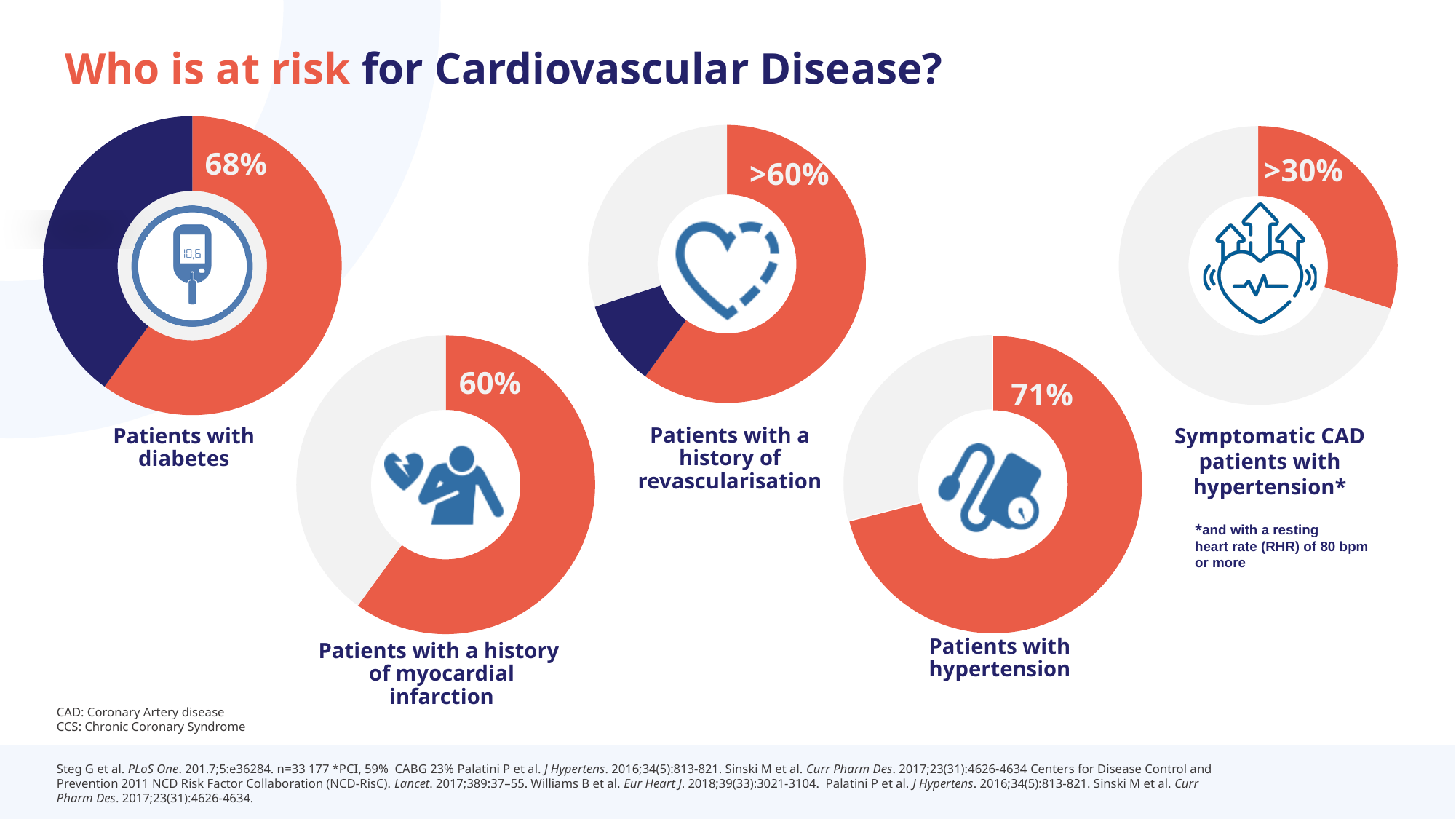
In the chart labelled 'Patients with a history of revascularisation', what value is printed? >60% Comparing the 'Patients with diabetes' chart and the 'Patients with hypertension' chart, which shows the larger percentage? Patients with hypertension In the chart labelled 'Patients with diabetes', what percentage is shown? 68% Across all the charts on the slide, which patient group has the highest printed percentage? Patients with hypertension What is the difference between the percentage in the 'Patients with hypertension' chart and the percentage in the 'Patients with diabetes' chart? 3 percentage points In the chart labelled 'Patients with hypertension', what percentage is shown? 71% In the chart labelled 'Symptomatic CAD patients with hypertension*', what value is printed? >30% Across all the charts on the slide, which patient group has the lowest printed value? Symptomatic CAD patients with hypertension* How many donut charts are shown on the slide? 5 In the chart labelled 'Patients with a history of myocardial infarction', what percentage is shown? 60% What is the difference between the percentage in the 'Patients with diabetes' chart and the percentage in the 'Patients with a history of myocardial infarction' chart? 8 percentage points What type of chart is used for 'Patients with diabetes'? Donut (pie) chart